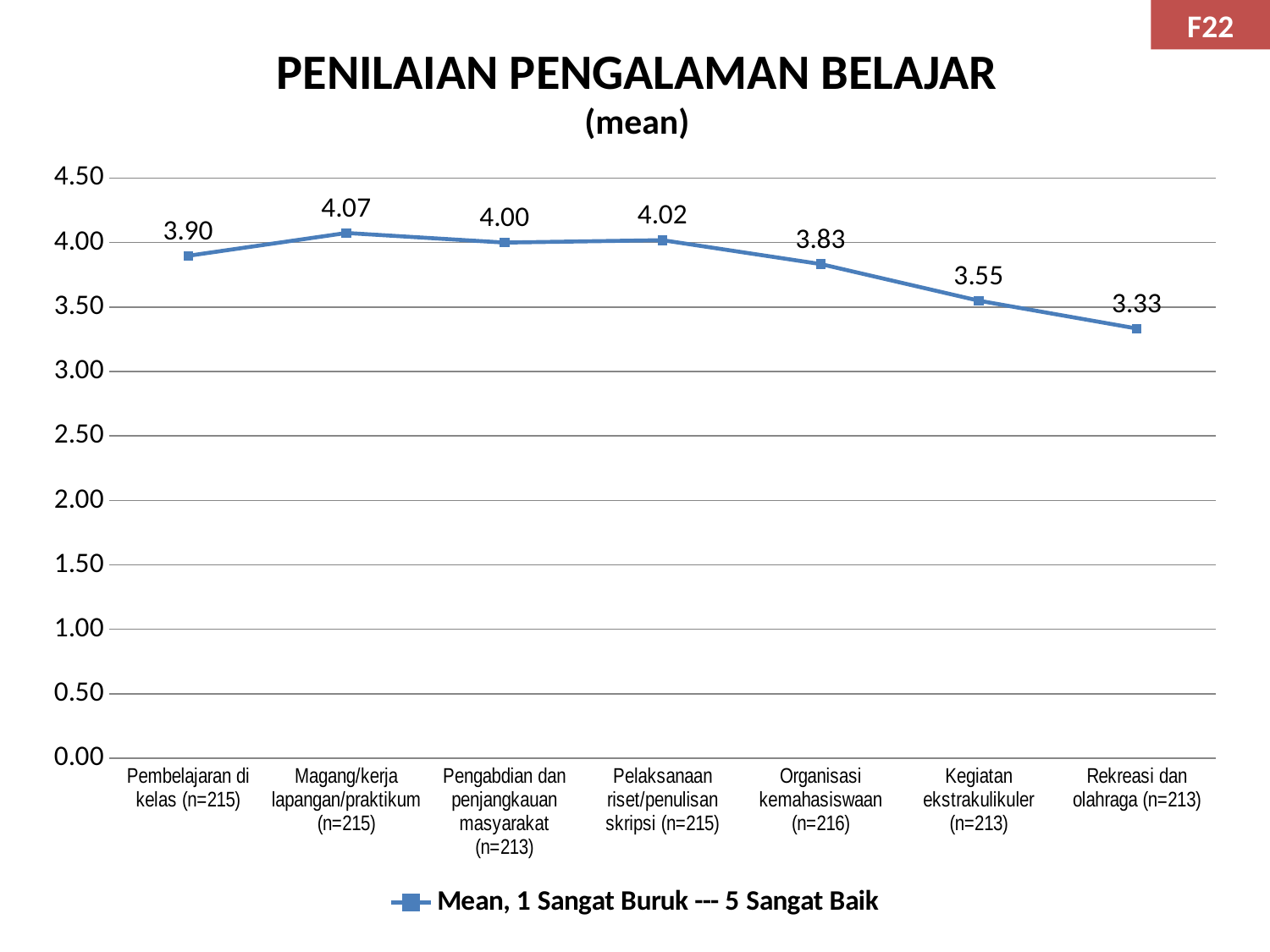
Which category has the lowest mean value? Rekreasi dan olahraga (n=213) What is the mean value for Rekreasi dan olahraga (n=213)? 3.33 Which is larger, the mean for Pembelajaran di kelas or the mean for Kegiatan ekstrakulikuler? Pembelajaran di kelas How many categories are plotted on the x axis? 7 What is the difference between the mean for Magang/kerja lapangan/praktikum and the mean for Rekreasi dan olahraga? 0.74 What is the mean value for Organisasi kemahasiswaan (n=216)? 3.83 What kind of chart is shown on the slide? line chart What is the mean value for Magang/kerja lapangan/praktikum (n=215)? 4.07 How many series does the legend list? 1 Is the value for Kegiatan ekstrakulikuler greater or less than 4.00? less Which category has the highest mean value? Magang/kerja lapangan/praktikum (n=215) What is the legend entry for the plotted series? Mean, 1 Sangat Buruk --- 5 Sangat Baik